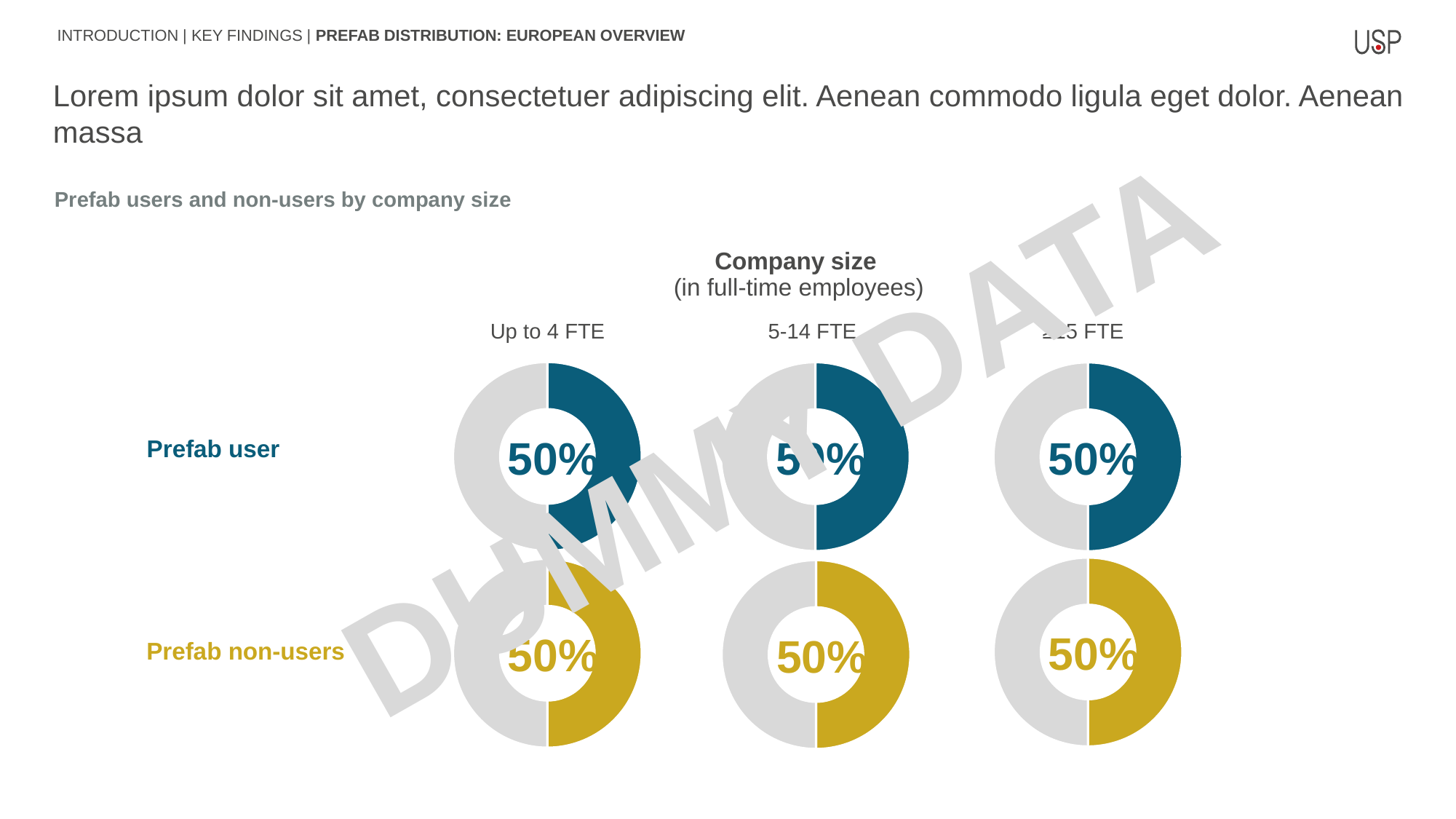
What is the title of the chart section on the slide? Prefab users and non-users by company size What colour are the Prefab user donut segments? blue Is the Prefab user value or the Prefab non-users value larger for the Up to 4 FTE company size? they are equal What is the value shown for Prefab non-users in the rightmost company size column? 50% What is the value shown for Prefab non-users in the Up to 4 FTE company size? 50% What kind of chart is used to show prefab users and non-users by company size? donut chart How many donut charts are shown on the slide? 6 What is the value shown for Prefab user in the rightmost company size column? 50% How many company size categories are shown across the top of the charts? 3 What is the value shown for Prefab user in the Up to 4 FTE company size? 50% What is the difference between the Prefab user and Prefab non-users values for the Up to 4 FTE company size? 0% What is the value shown for Prefab non-users in the 5-14 FTE company size? 50%